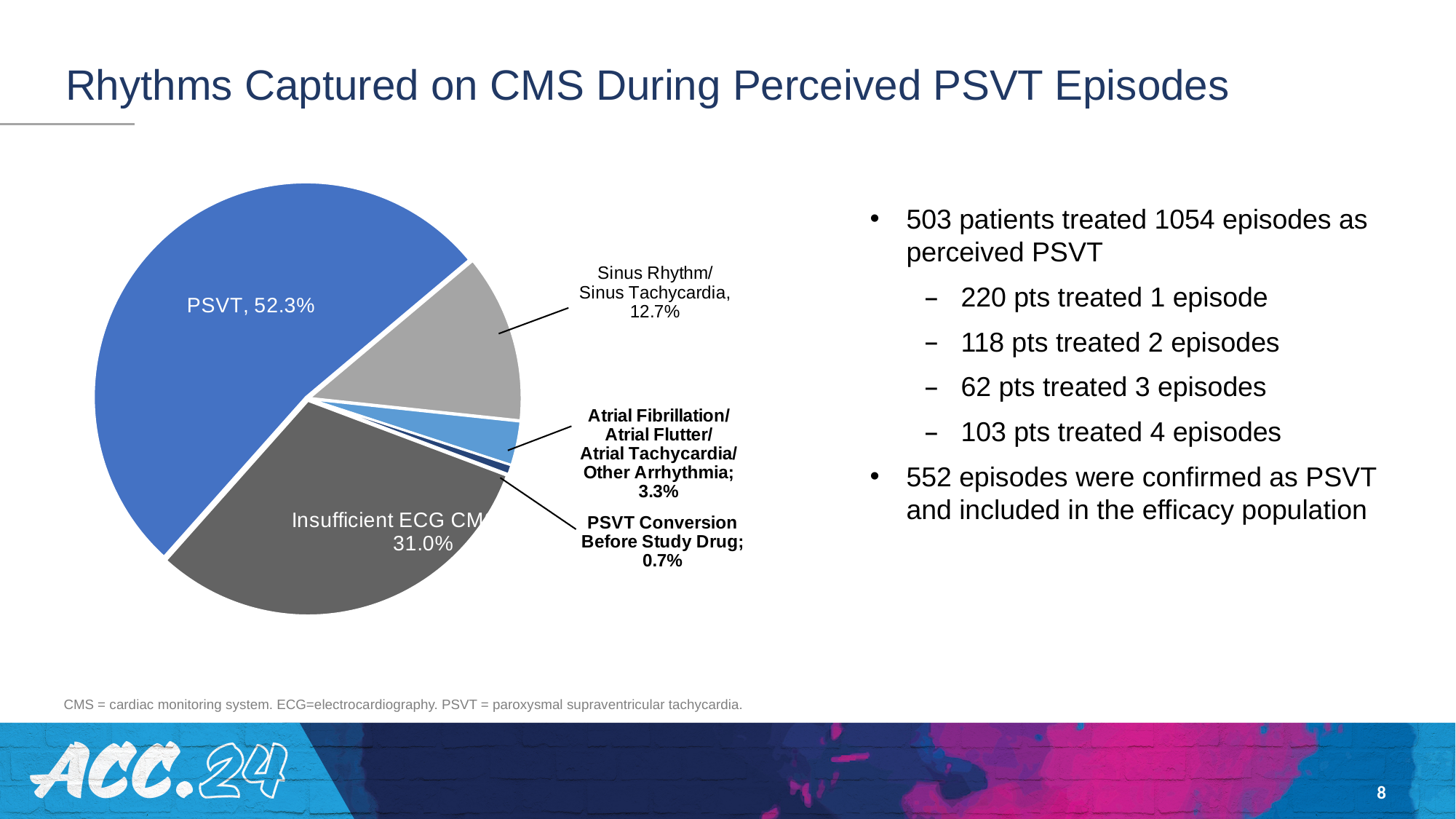
How many slices does the pie chart have? 5 What is the title of the slide containing the pie chart? Rhythms Captured on CMS During Perceived PSVT Episodes What percentage is shown for Atrial Fibrillation/Atrial Flutter/Atrial Tachycardia/Other Arrhythmia? 3.3% What kind of chart is shown on the slide? Pie chart What percentage is shown for the Insufficient ECG slice? 31.0% Which is larger, the Sinus Rhythm/Sinus Tachycardia slice or the Atrial Fibrillation/Atrial Flutter/Atrial Tachycardia/Other Arrhythmia slice? Sinus Rhythm/Sinus Tachycardia What percentage is shown for Sinus Rhythm/Sinus Tachycardia? 12.7% What is the difference in percentage points between the PSVT slice and the Insufficient ECG slice? 21.3 Which slice of the pie is the largest? PSVT What share of the pie is labelled PSVT? 52.3% Which slice of the pie is the smallest? PSVT Conversion Before Study Drug What percentage is shown for PSVT Conversion Before Study Drug? 0.7%